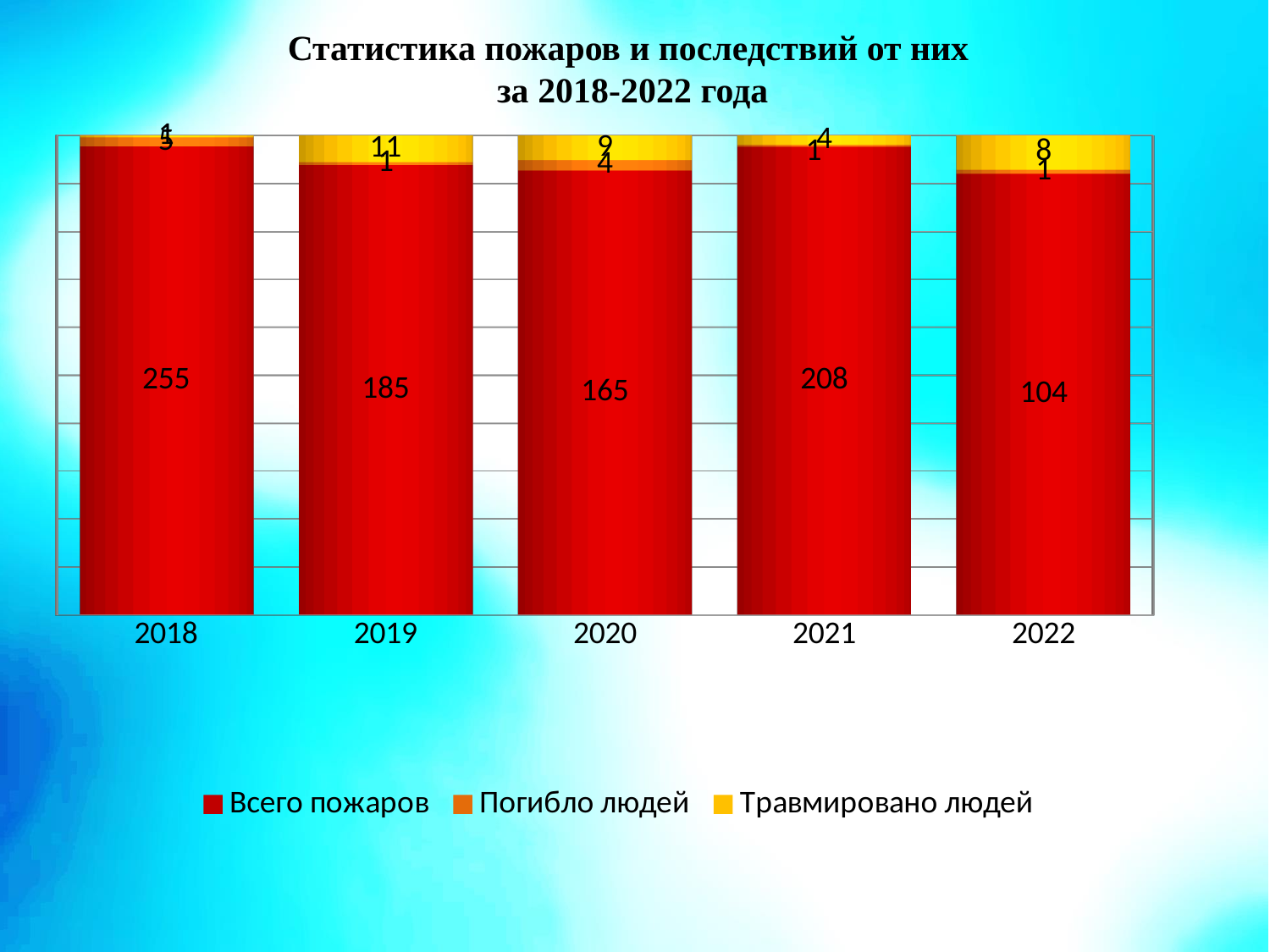
How many years are shown on the x axis? 5 What is the difference between Всего пожаров in 2018 and 2022? 151 What is the total of the stacked bar for 2021? 213 How many series does the legend list? 3 What is the value of Всего пожаров for 2022? 104 What is the value of Погибло людей for 2020? 4 What is the value of Всего пожаров for 2018? 255 Which year has the lowest value of Всего пожаров? 2022 Which year has the highest value of Всего пожаров? 2018 What is the value of Травмировано людей for 2019? 11 What kind of chart is shown on the slide? Stacked bar chart Which is larger, Всего пожаров in 2019 or in 2021? 2021